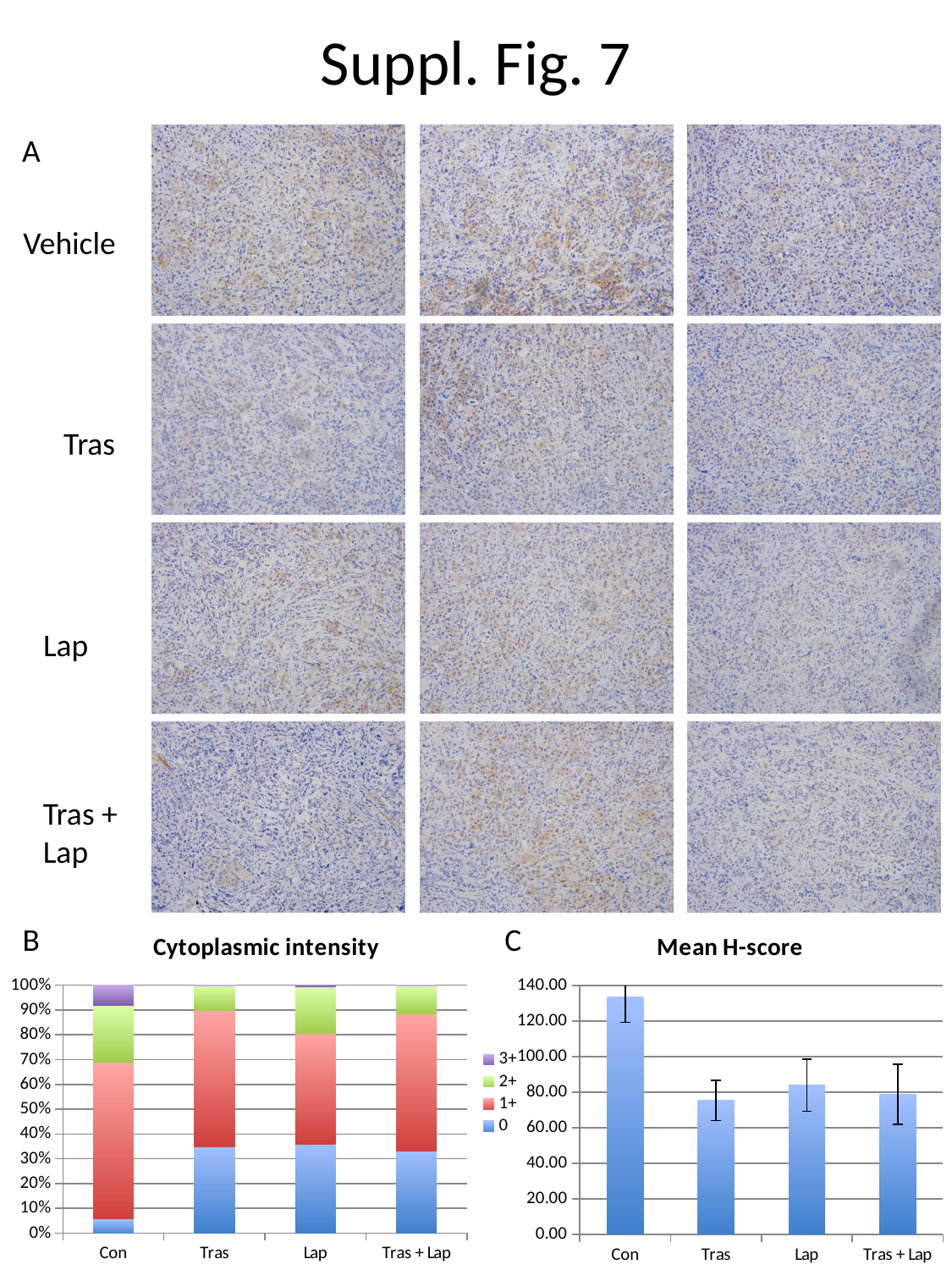
In the Mean H-score chart, is the value for Lap greater or less than 100.00? less How many categories are shown on the x axis of the Mean H-score chart? 4 In the Cytoplasmic intensity chart, is the 0 segment for Con greater or less than 10%? less In the Mean H-score chart, is the value for Con greater or less than 120.00? greater In the Mean H-score chart, which category has the highest value? Con In the Cytoplasmic intensity chart, which category has the smallest share of the 0 series? Con In the Cytoplasmic intensity chart, which legend entry is shown in purple? 3+ What kind of chart is the Mean H-score chart? bar chart How many series does the legend of the Cytoplasmic intensity chart list? 4 In the Mean H-score chart, which is larger, the value for Con or the value for Lap? Con What kind of chart is the Cytoplasmic intensity chart? stacked bar chart